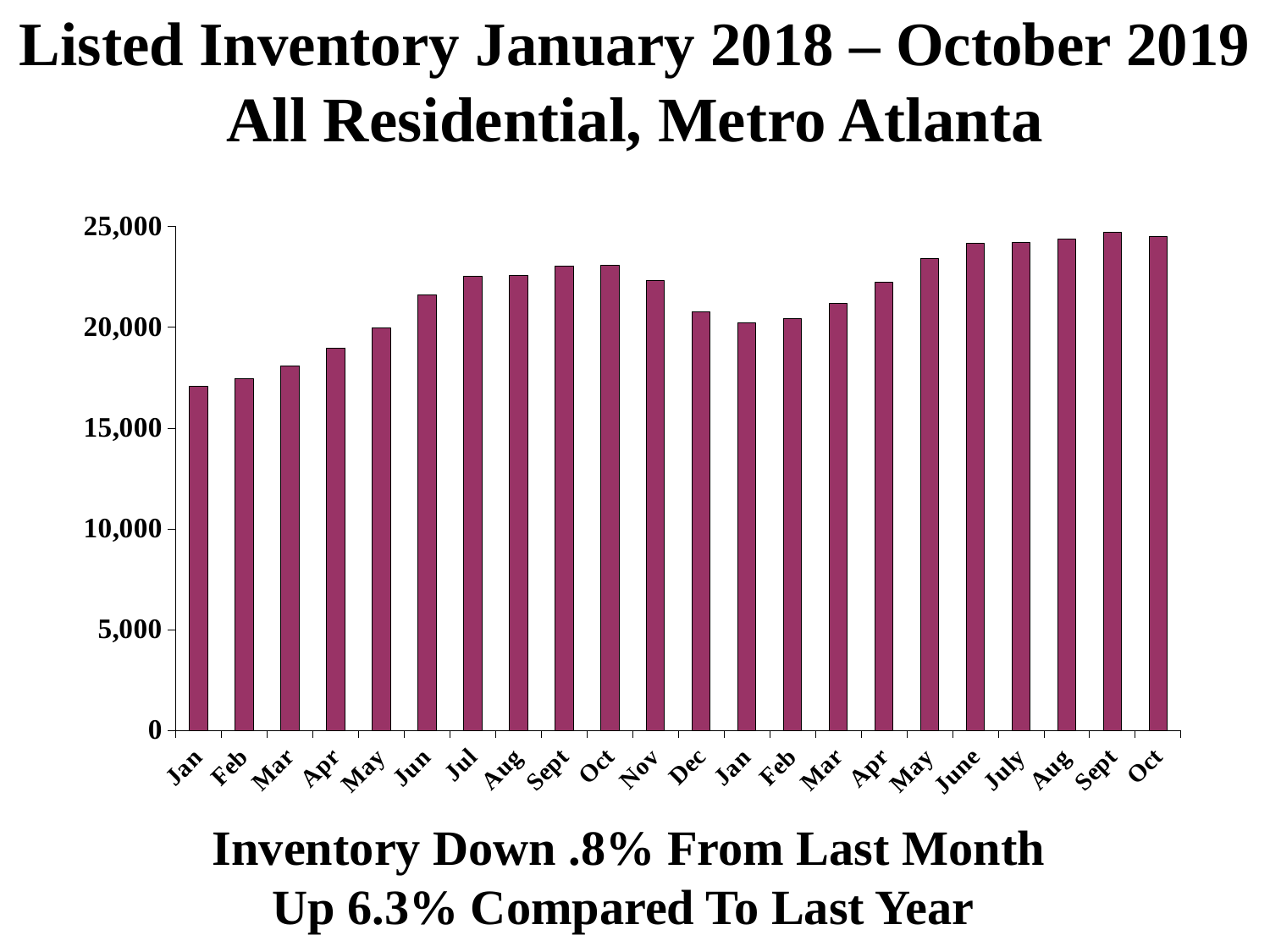
How many bars (months) are plotted in the chart? 22 Which is larger, the value for Mar 2018 or the value for Jun 2018? Jun 2018 Is the value for Dec (2018) greater or less than 20,000? greater What kind of chart is shown on the slide? Bar chart Is the value for Apr (2018) greater or less than 20,000? less Which month has the lowest listed inventory in the chart? Jan (2018) Which is larger, the value for Jan 2018 or the value for Jan 2019? Jan 2019 Is the value for Jun (2018) greater or less than 20,000? greater What is the title of the chart? Listed Inventory January 2018 – October 2019 All Residential, Metro Atlanta Do the values rise or fall from Jan 2018 through Oct 2018? Rise